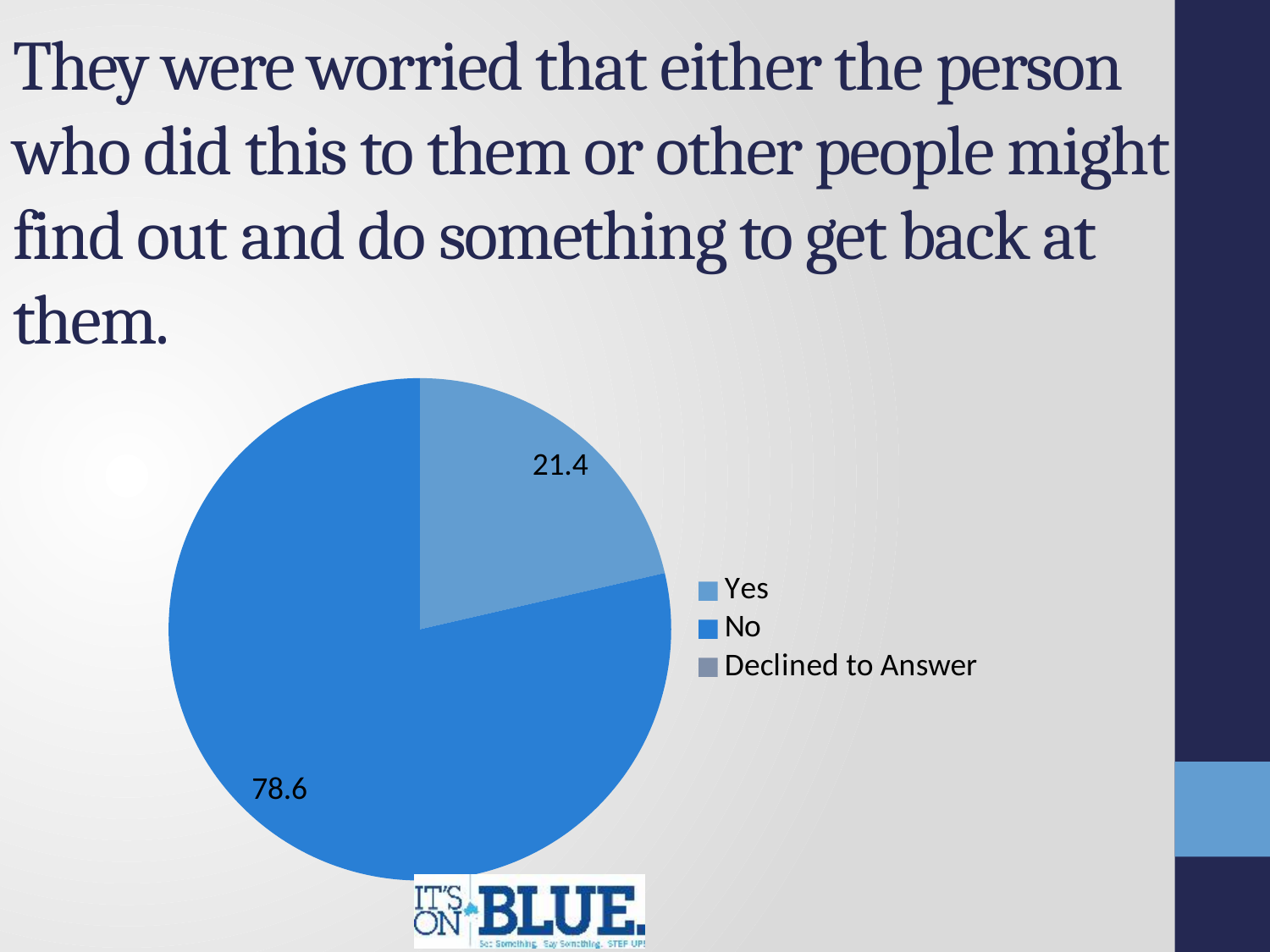
What kind of chart is shown on the slide? pie chart Which category has the largest slice of the pie? No How many entries does the legend list? 3 Which of the two labelled slices is larger, "Yes" or "No"? No What is the value for the "No" slice? 78.6 What is the difference between the "No" value and the "Yes" value? 57.2 How many slices have a visible data label on the pie? 2 What is the value for the "Yes" slice? 21.4 What is the third entry listed in the legend? Declined to Answer Which legend entry has no visible slice in the pie? Declined to Answer